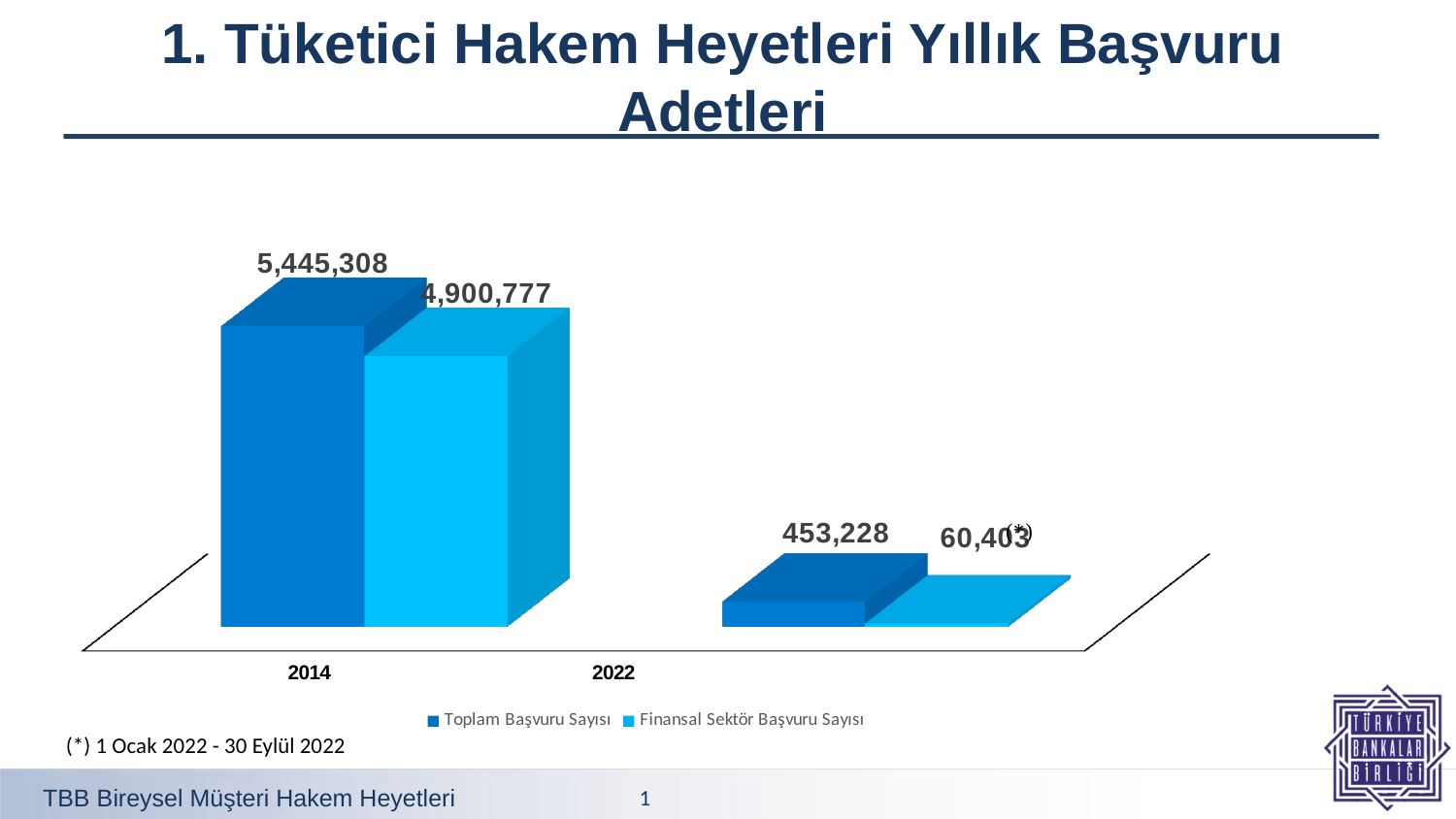
Which year has the higher Toplam Başvuru Sayısı? 2014 What is the Toplam Başvuru Sayısı value for 2022? 453,228 Which year has the lower Finansal Sektör Başvuru Sayısı? 2022 What is the difference between Toplam Başvuru Sayısı and Finansal Sektör Başvuru Sayısı in 2014? 544,531 What is the Finansal Sektör Başvuru Sayısı value for 2014? 4,900,777 Do the Toplam Başvuru Sayısı values rise or fall from 2014 to 2022? Fall How many years are shown on the x axis? 2 What type of chart is shown on the slide? Bar chart In 2022, which is larger: Toplam Başvuru Sayısı or Finansal Sektör Başvuru Sayısı? Toplam Başvuru Sayısı What is the Toplam Başvuru Sayısı value for 2014? 5,445,308 What is the difference between the Toplam Başvuru Sayısı values for 2014 and 2022? 4,992,080 How many series does the legend list? 2